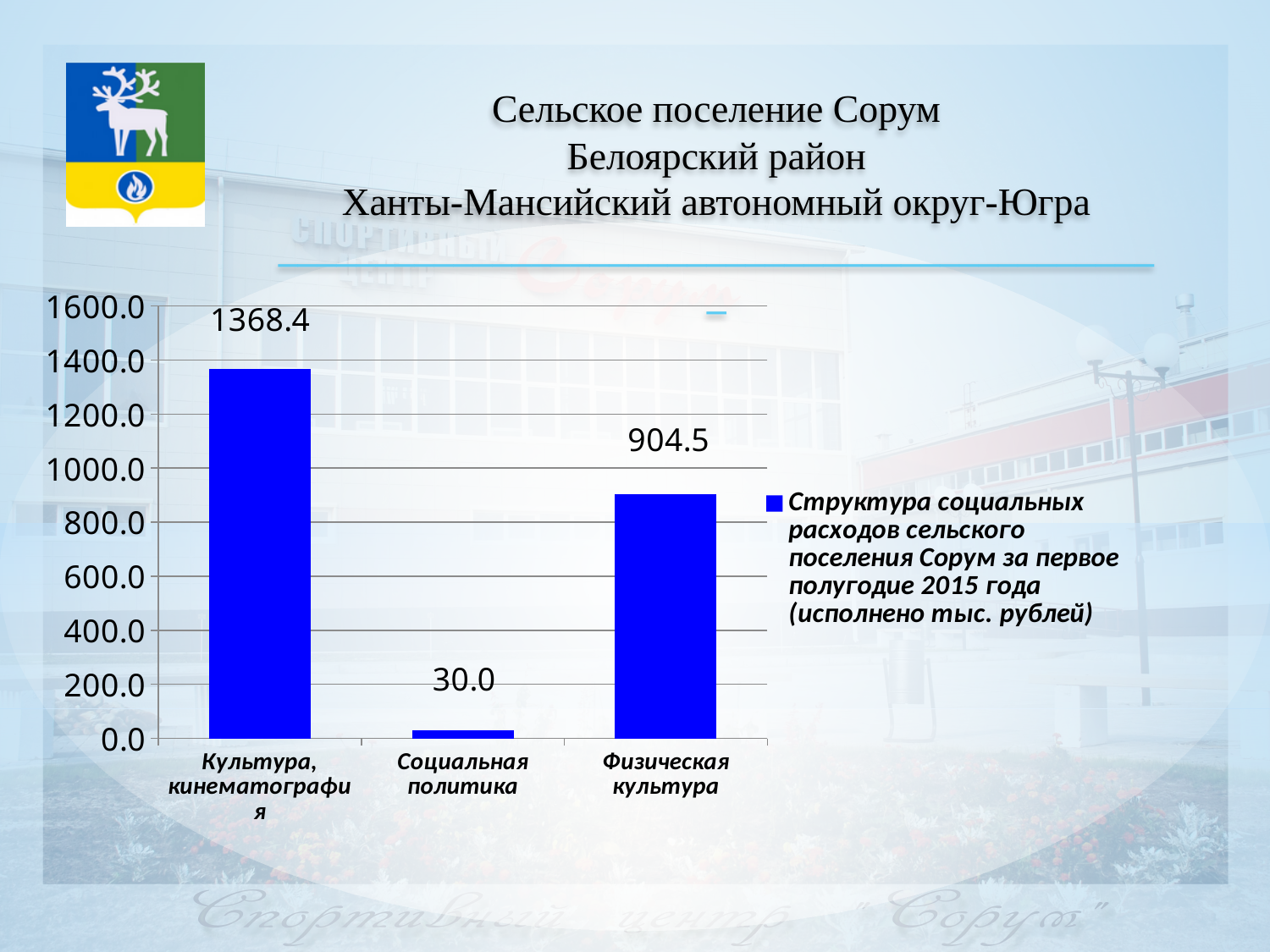
How many categories are shown on the x axis? 3 What kind of chart is shown on the slide? bar chart What is the difference between the values for Культура, кинематография and Физическая культура? 463.9 How many series does the legend list? 1 Is the value for Физическая культура greater or less than 1000.0? less What is the value for Физическая культура? 904.5 What is the value for Социальная политика? 30.0 What is the difference between the values for Физическая культура and Социальная политика? 874.5 Which is larger, the value for Физическая культура or the value for Социальная политика? Физическая культура What is the value for Культура, кинематография? 1368.4 Which category has the highest value? Культура, кинематография Which category has the lowest value? Социальная политика